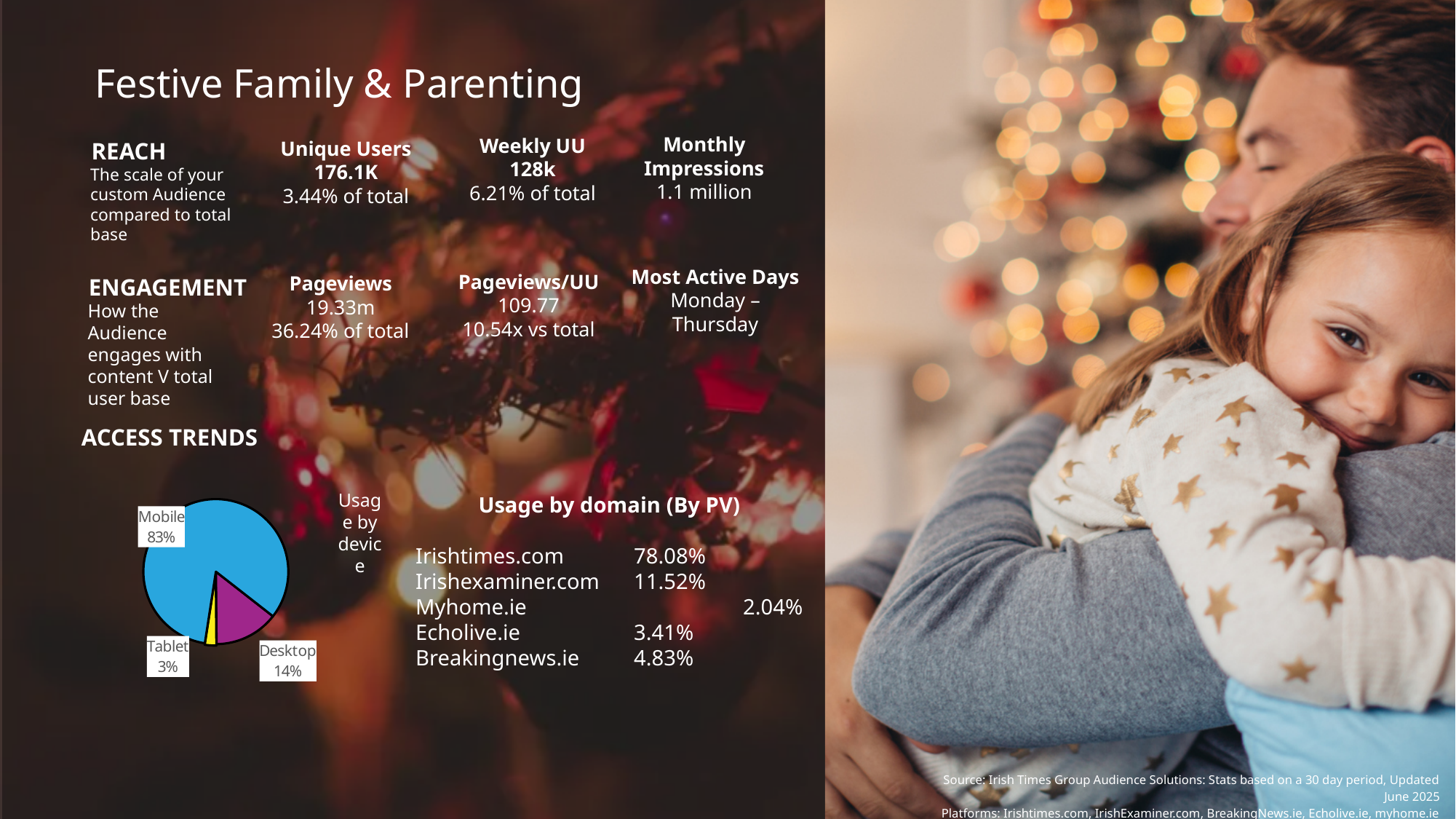
In the 'Usage by device' pie chart, how many device categories are shown? 3 In the 'Usage by device' pie chart, which device has the largest share? Mobile In the 'Usage by device' pie chart, what is the difference in percentage points between Mobile and Desktop? 69 In the 'Usage by device' pie chart, what share does Mobile have? 83% In the 'Usage by device' pie chart, what share does Tablet have? 3% In the 'Usage by device' pie chart, what share does Desktop have? 14% In the 'Usage by device' pie chart, what is the difference in percentage points between Desktop and Tablet? 11 In the 'Usage by device' pie chart, what colour is the Mobile slice? blue In the 'Usage by device' pie chart, which is larger, Desktop or Tablet? Desktop What kind of chart is the 'Usage by device' chart? pie chart In the 'Usage by device' pie chart, what colour is the Desktop slice? purple In the 'Usage by device' pie chart, which device has the smallest share? Tablet